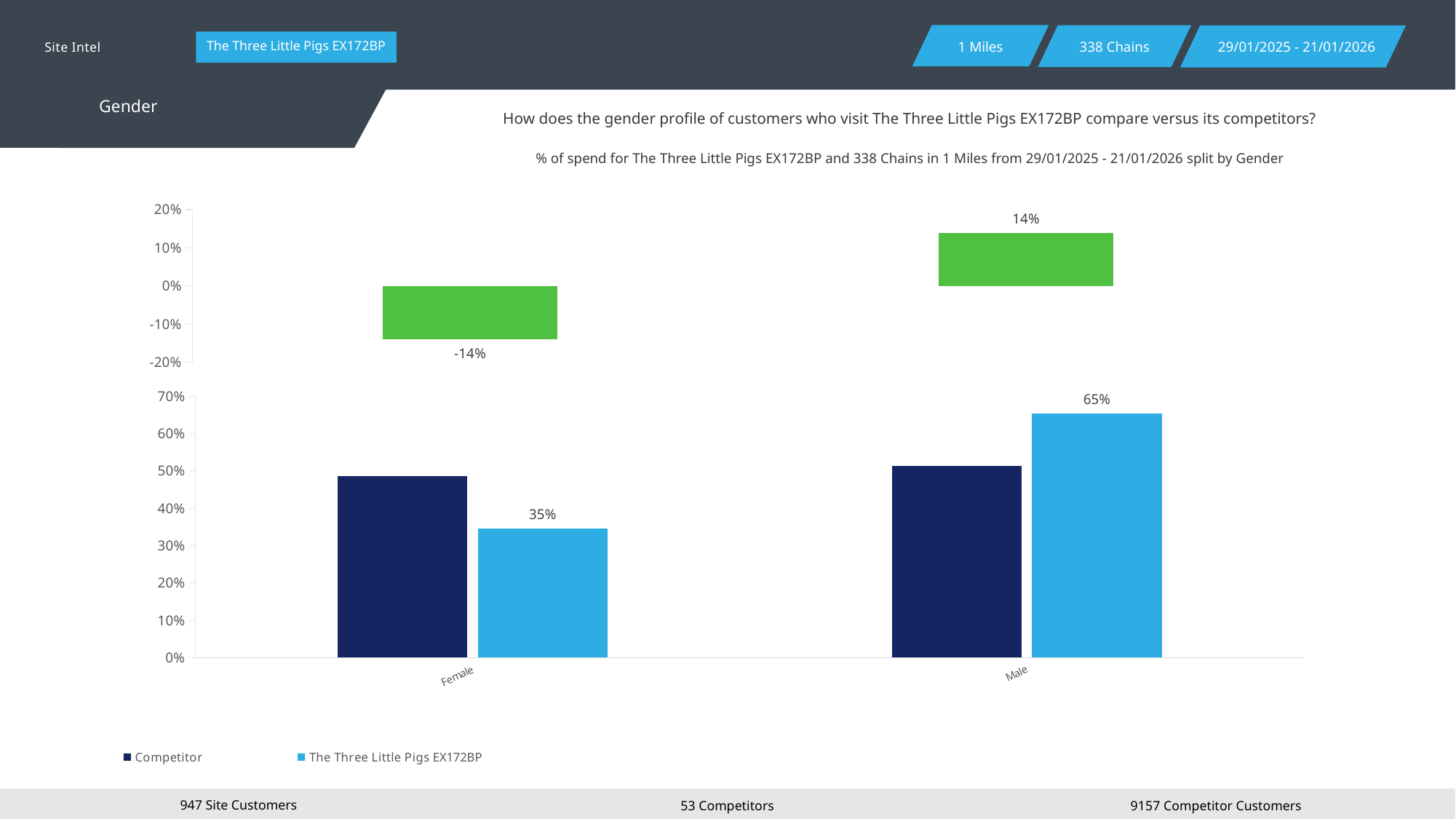
In the bottom chart, which gender has the higher value for The Three Little Pigs EX172BP? Male In the bottom chart, what is the difference between the Male and Female values for The Three Little Pigs EX172BP? 30% In the bottom chart, for Female, which is larger: the Competitor value or The Three Little Pigs EX172BP value? Competitor In the top chart, what is the value shown for Female? -14% In the bottom chart, what is the value for The Three Little Pigs EX172BP for Male? 65% What kind of chart is the bottom chart? Bar chart In the bottom chart, is the Competitor value for Male greater or less than 60%? less In the top chart, what is the value shown for Male? 14% How many series does the legend of the bottom chart list? 2 In the bottom chart, is the Competitor value for Female greater or less than 40%? greater In the bottom chart, for Male, which is larger: the Competitor value or The Three Little Pigs EX172BP value? The Three Little Pigs EX172BP In the bottom chart, what is the value for The Three Little Pigs EX172BP for Female? 35%